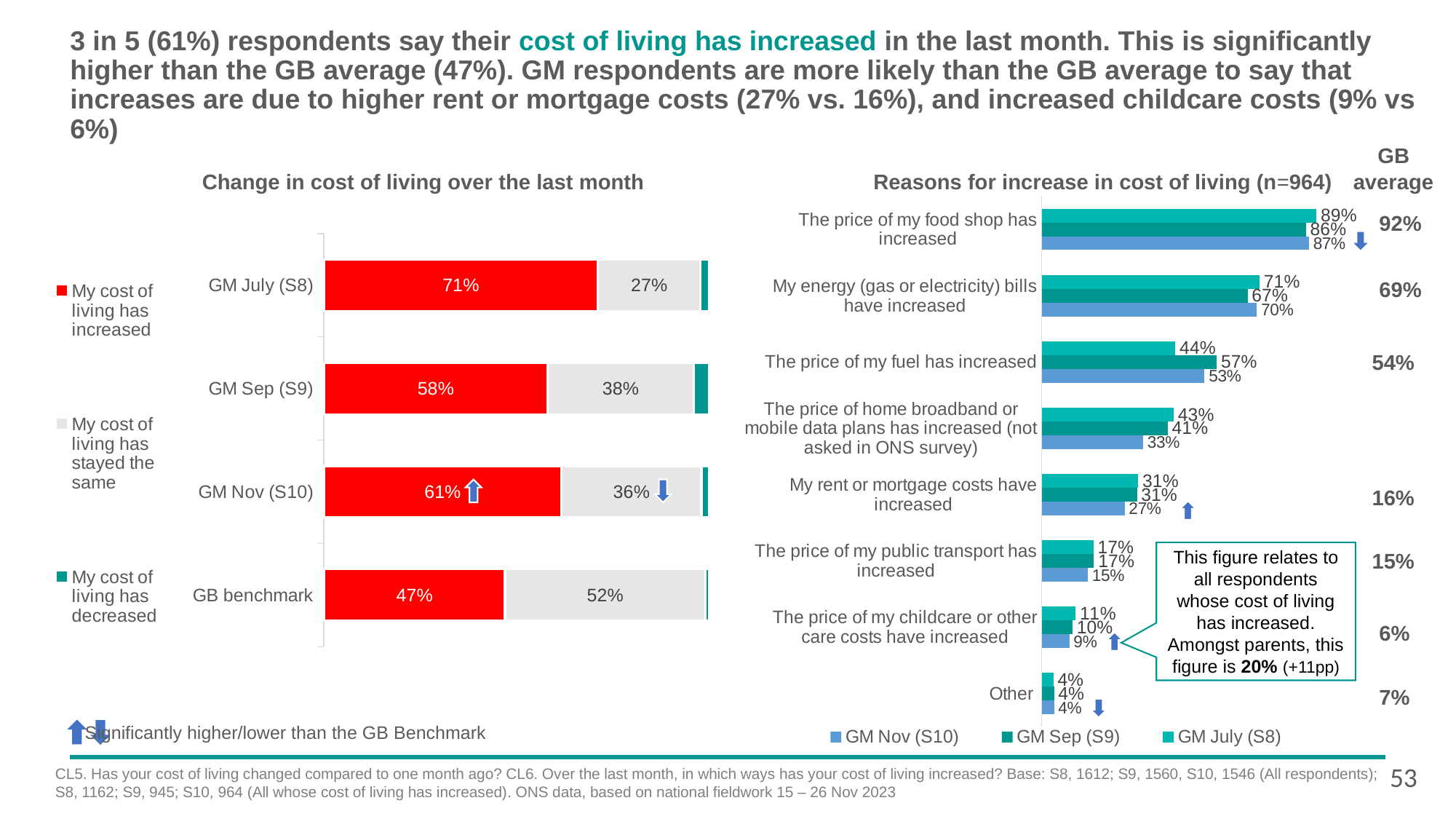
What type of chart is the 'Change in cost of living over the last month' chart? Stacked bar chart In the 'Reasons for increase in cost of living (n=964)' chart, what is the GM Sep (S9) value for 'The price of my fuel has increased'? 57% In the 'Reasons for increase in cost of living (n=964)' chart, which reason has the highest GM Nov (S10) value? The price of my food shop has increased In the 'Change in cost of living over the last month' chart, what is the difference between the GM Nov (S10) and GB benchmark shares saying cost of living has increased? 14 percentage points In the 'Change in cost of living over the last month' chart, what percentage of GB benchmark respondents said their cost of living has stayed the same? 52% How many series does the legend of the 'Reasons for increase in cost of living (n=964)' chart list? 3 In the 'Change in cost of living over the last month' chart, which group has the lowest share saying their cost of living has increased? GB benchmark In the 'Change in cost of living over the last month' chart, how many groups (bars) are shown? 4 In the 'Reasons for increase in cost of living (n=964)' chart, what is the GM Nov (S10) value for 'The price of my food shop has increased'? 87% In the 'Change in cost of living over the last month' chart, what percentage of GM July (S8) respondents said their cost of living has increased? 71% In the 'Reasons for increase in cost of living (n=964)' chart, is the GM July (S8) value for 'The price of my fuel has increased' larger or smaller than the GM Sep (S9) value? smaller In the 'Reasons for increase in cost of living (n=964)' chart, what is the difference between the GM July (S8) and GM Nov (S10) values for 'The price of home broadband or mobile data plans has increased'? 10 percentage points